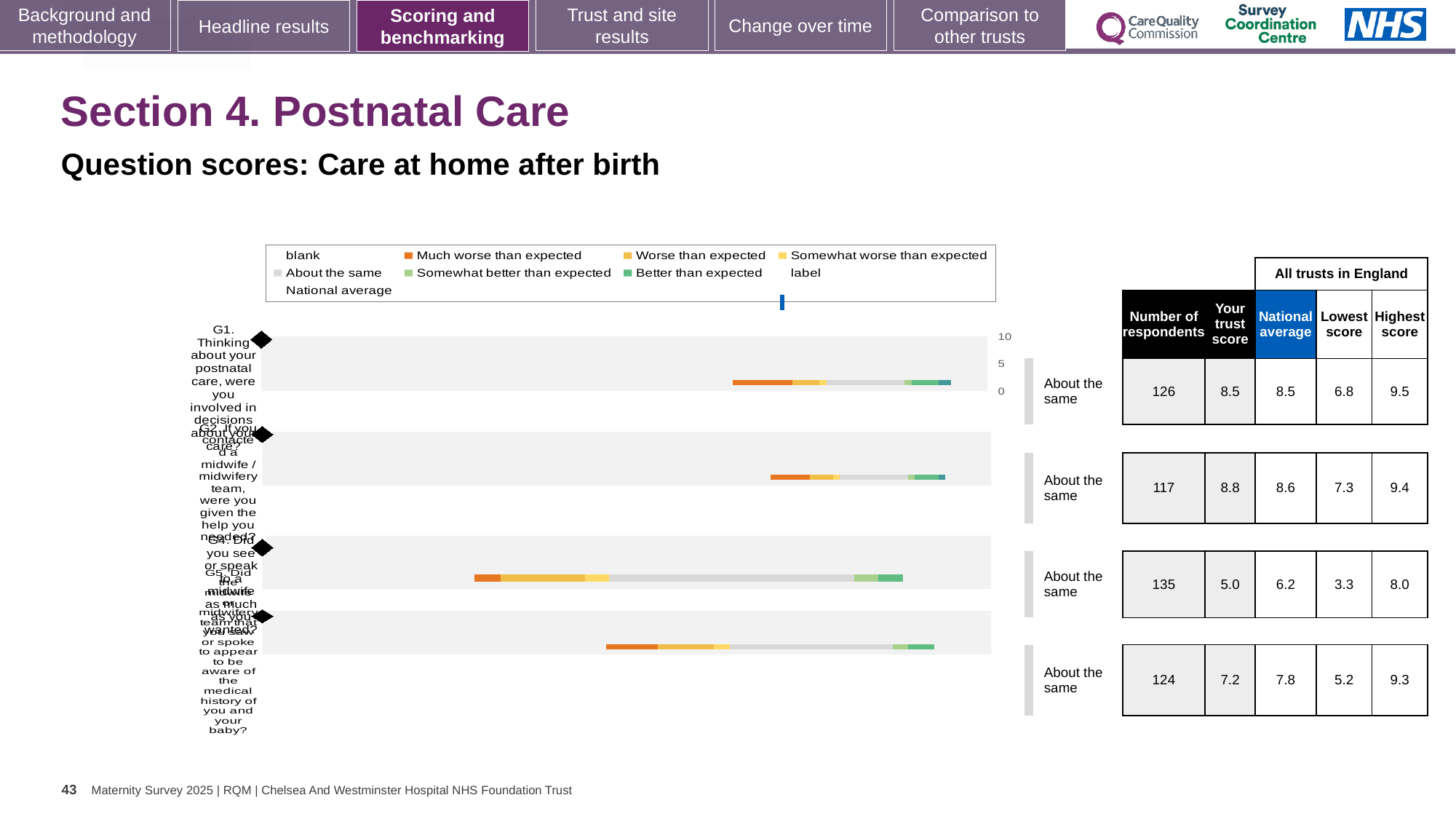
Which row in the table has the highest 'Your trust score'? the second row (G2), 8.8 What benchmark label is shown next to each of the four bars? About the same What is the difference between the highest score and the lowest score for the first row (G1) in the table? 2.7 How many question rows (bars) are plotted in the chart? 4 For the fourth row in the table, which is larger: the trust score or the national average? the national average (7.8) In the table beside the chart, what is the trust score for the second row (G2)? 8.8 What kind of chart is shown on the slide? bar chart In the table beside the chart, what is the national average for the third row? 6.2 What is the maximum value shown on the chart's score axis? 10 What colour represents 'Much worse than expected' in the legend? orange Which row in the table has the lowest 'Your trust score'? the third row, 5.0 In the table beside the chart, what is the number of respondents for the first row (G1)? 126